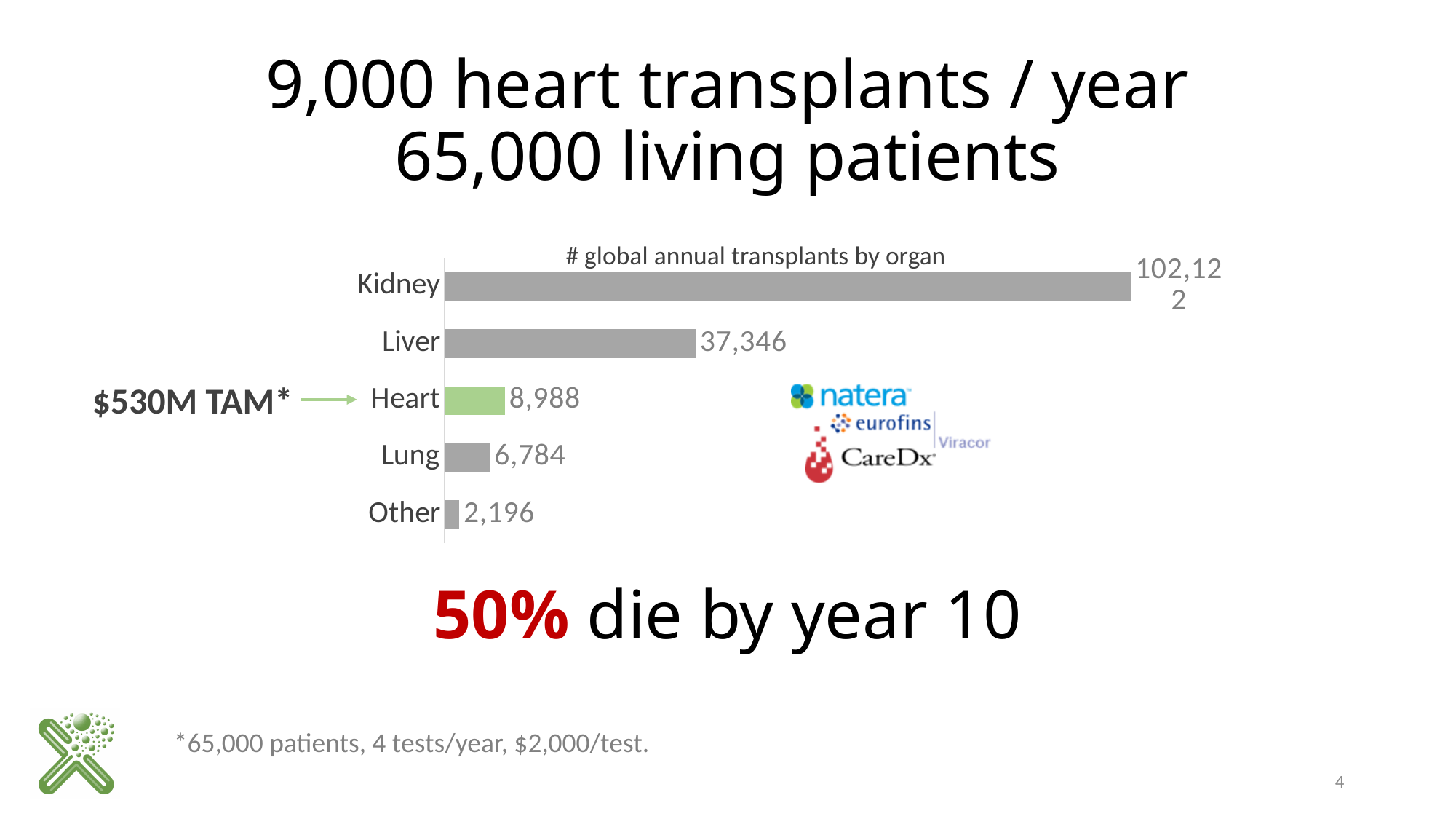
What is the value for Heart in the chart? 8,988 What is the title of the chart? # global annual transplants by organ Which is larger, the value for Heart or the value for Lung? Heart What kind of chart is shown on the slide? Bar chart What is the value for Other in the chart? 2,196 Which category has the lowest value in the chart? Other Which organ has the highest number of global annual transplants? Kidney What is the value for Liver in the chart? 37,346 What is the value for Kidney in the chart? 102,122 What is the value for Lung in the chart? 6,784 What is the difference between the Liver and Heart values? 28,358 How many categories are shown in the chart? 5